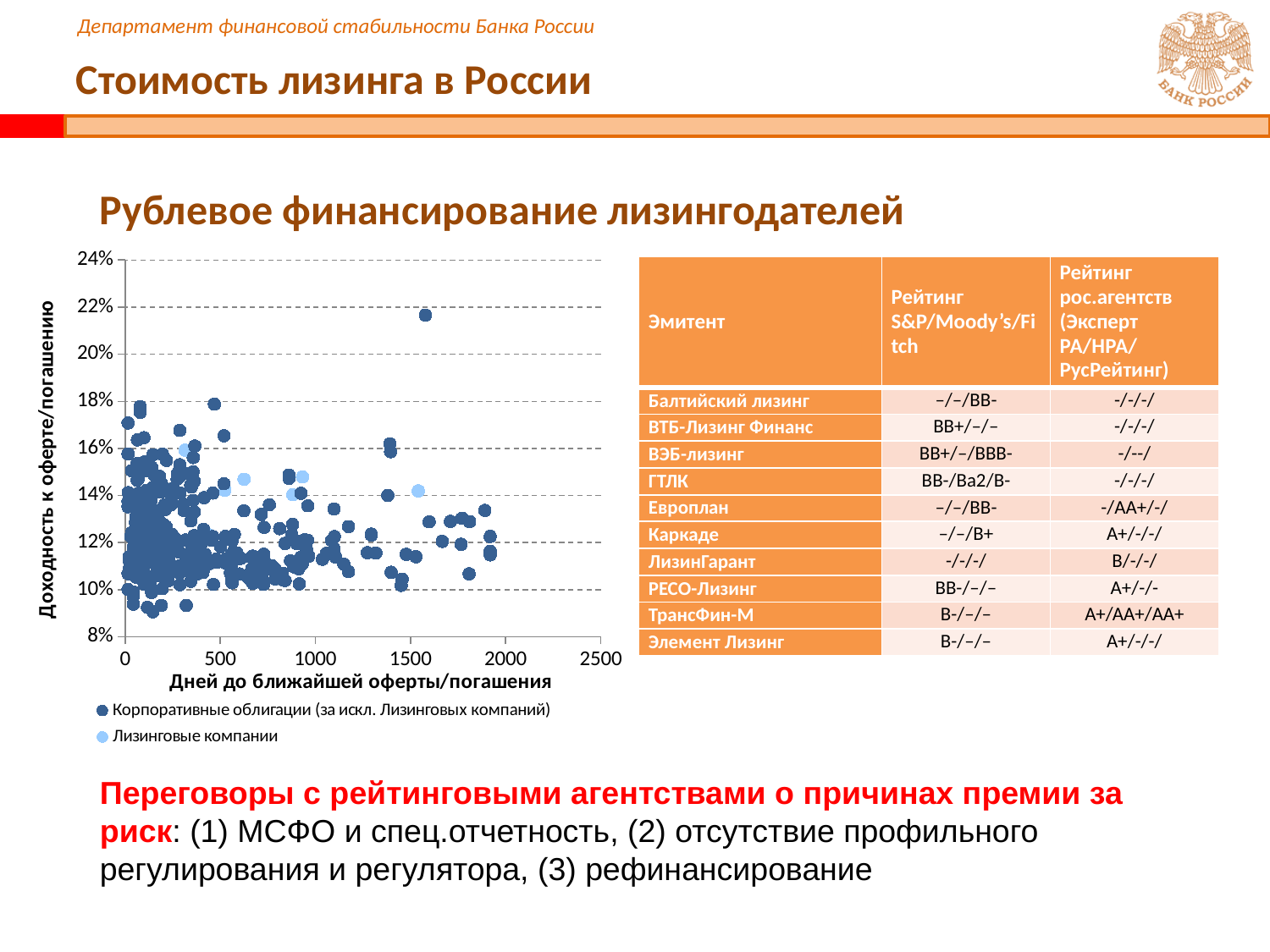
Is the lowest plotted yield in the chart greater or less than 10%? less How many series does the chart legend list? 2 Are any points plotted beyond 2000 days on the x axis? No Which series is shown in light blue in the chart legend? Лизинговые компании Is the point with the highest yield located at more or less than 1500 days to the nearest offer/maturity? more What kind of chart is shown on the slide? scatter chart What is the title of the chart? Рублевое финансирование лизингодателей